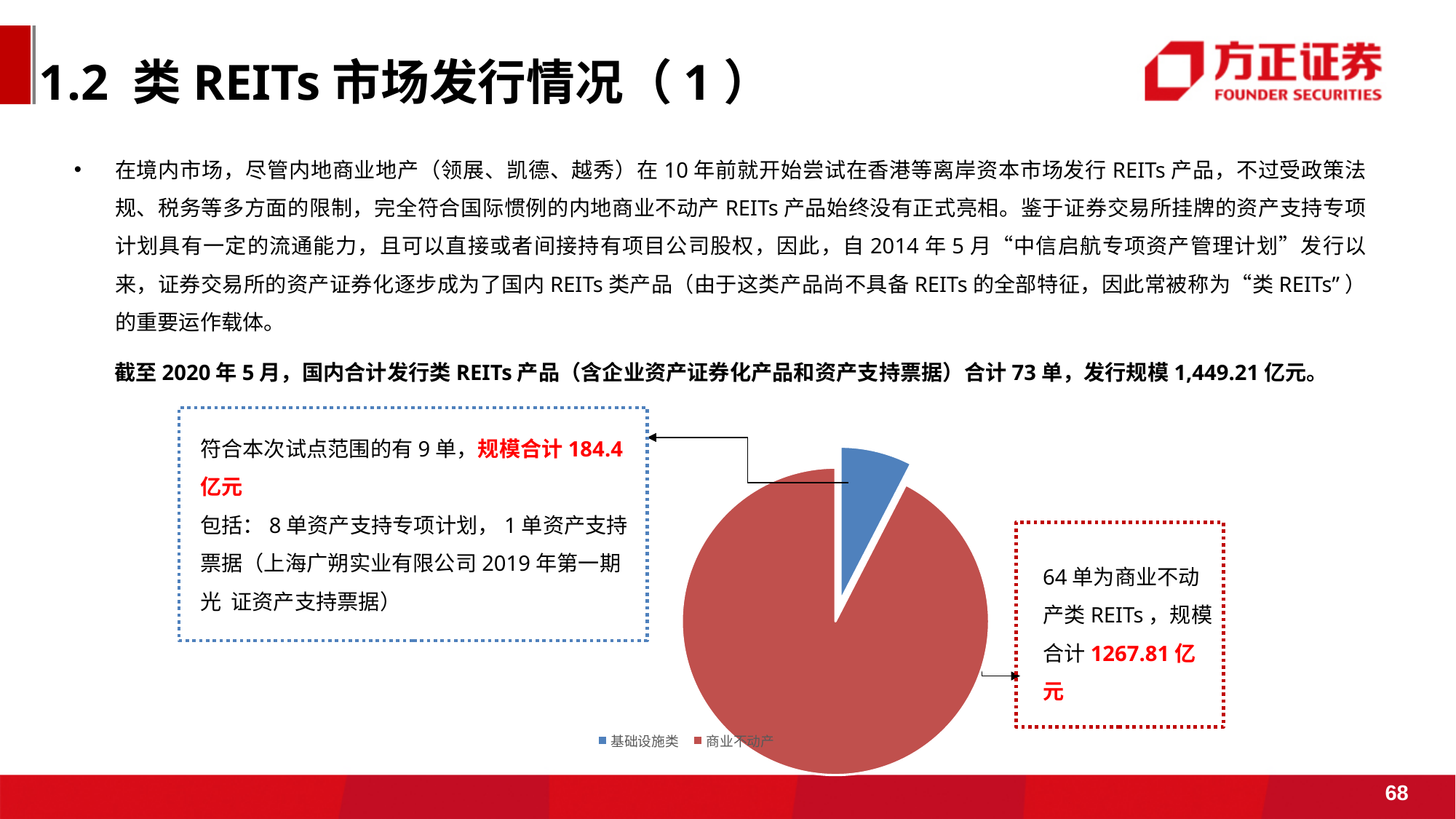
What colour is the 基础设施类 slice in the pie chart? blue According to the callout for the 基础设施类 slice, what is the total issuance scale (规模合计) of that category? 184.4 亿元 What is the difference in issuance scale between 商业不动产 (1267.81 亿元) and 基础设施类 (184.4 亿元)? 1083.41 亿元 Which category takes the largest share of the pie chart? 商业不动产 How many slices does the pie chart have? 2 How many deals (单) fall into the 商业不动产 category according to the callout? 64 单 How many entries does the pie chart's legend list? 2 What kind of chart is shown on the slide? pie chart Which is larger in issuance scale, 基础设施类 or 商业不动产? 商业不动产 Which category takes the smallest share of the pie chart? 基础设施类 How many deals (单) fall into the 基础设施类 category according to the callout? 9 单 According to the callout for the 商业不动产 slice, what is the total issuance scale (规模合计) of that category? 1267.81 亿元